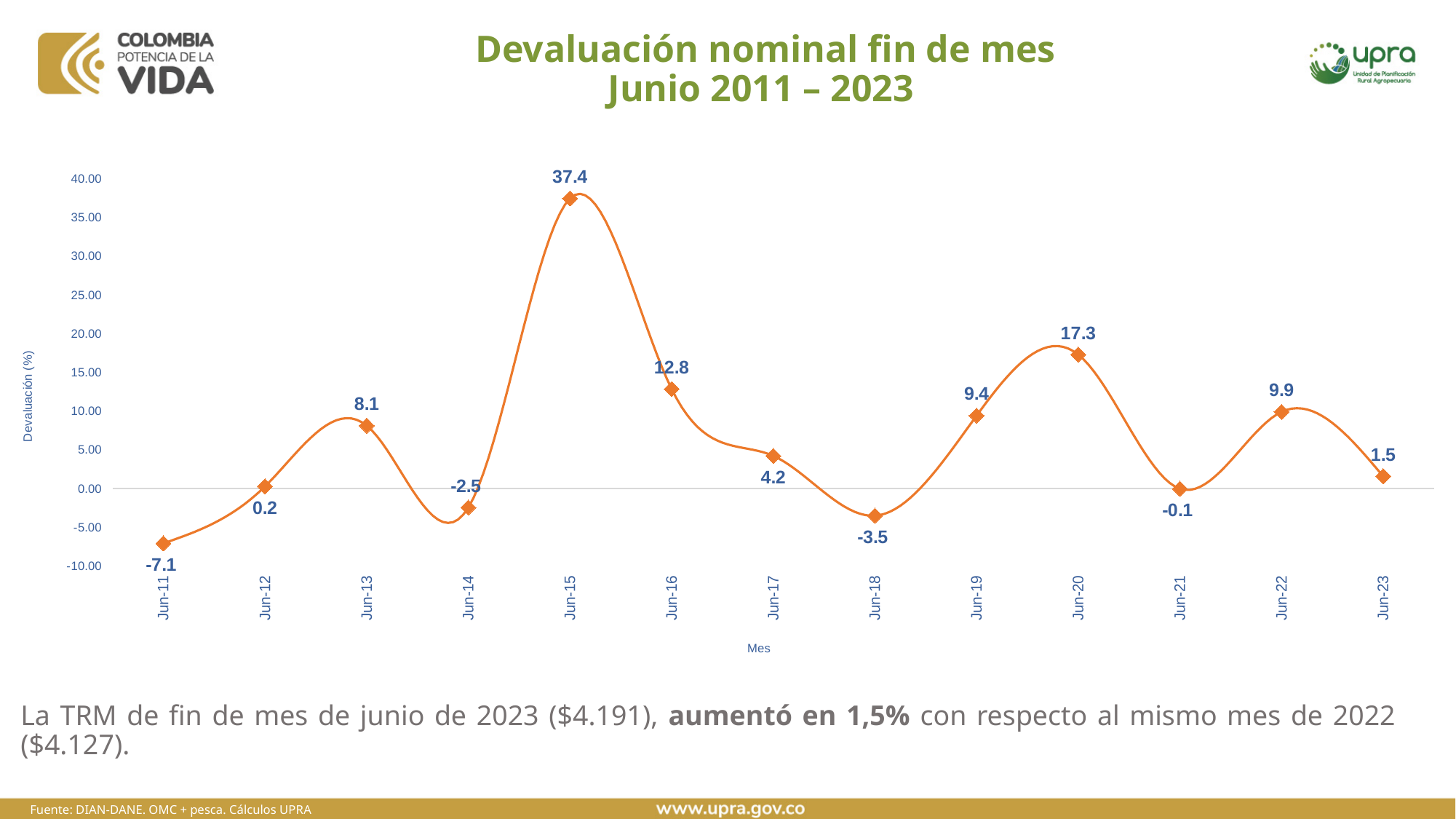
What is the title of the chart? Devaluación nominal fin de mes Junio 2011 – 2023 What is the difference between the values for Jun-15 and Jun-16? 24.6 What is the value for Jun-20? 17.3 Is the value for Jun-20 greater or less than 15.00? greater Do the values rise or fall from Jun-20 to Jun-21? fall What kind of chart is shown on the slide? line chart What is the value for Jun-11? -7.1 Which month has the highest value? Jun-15 Which month has the lowest value? Jun-11 How many data points are plotted on the chart? 13 What is the value for Jun-15? 37.4 Which is larger, the value for Jun-19 or the value for Jun-22? Jun-22